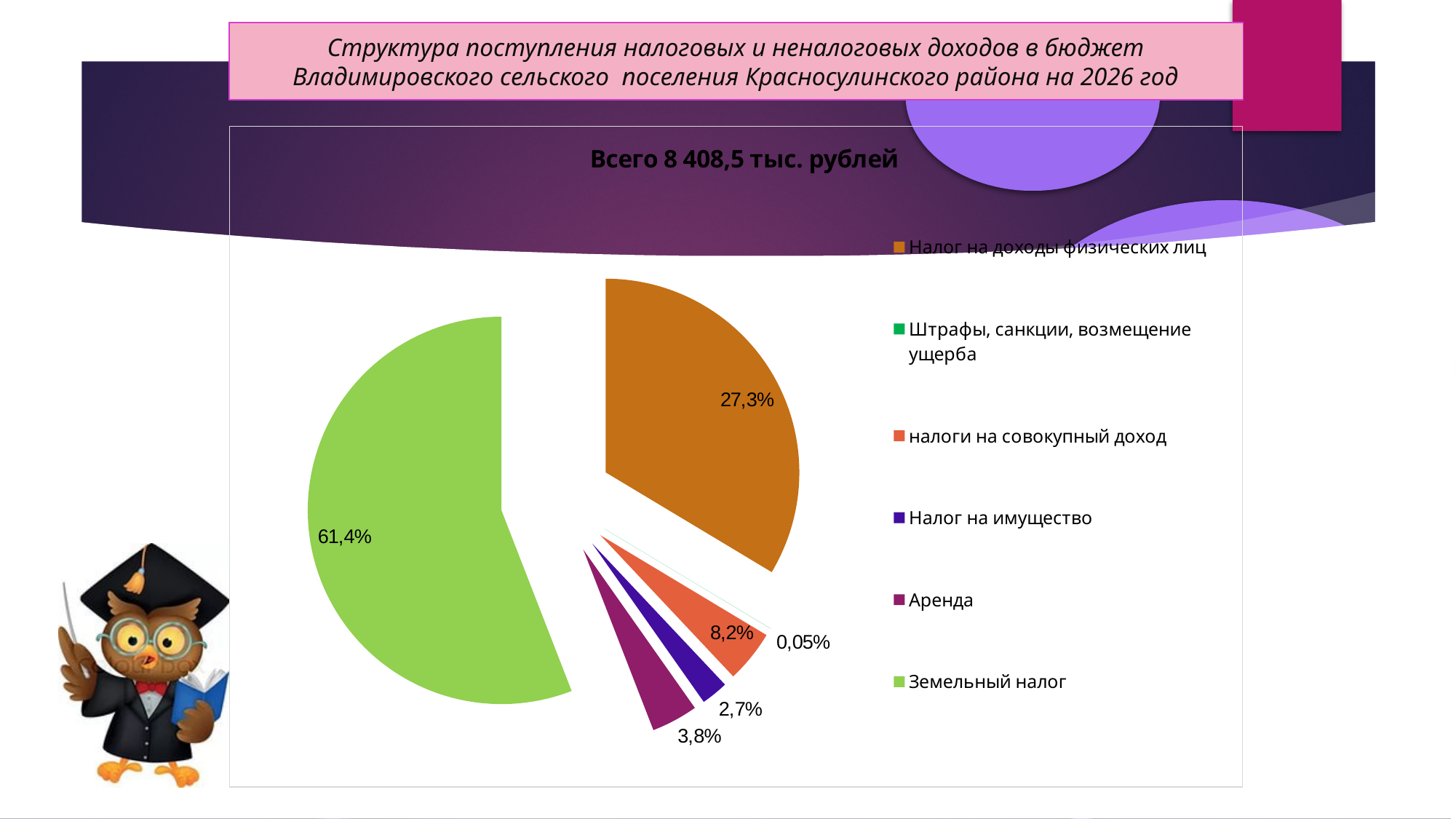
Which category has the smallest share of the pie? Штрафы, санкции, возмещение ущерба Which has the larger share, Аренда or Налог на имущество? Аренда What is the difference in percentage points between the shares of Земельный налог and Налог на доходы физических лиц? 34,1 What share of the pie does Аренда account for? 3,8% What share of the pie does налоги на совокупный доход account for? 8,2% How many categories does the legend list? 6 What share of the pie does Налог на имущество account for? 2,7% What total amount is stated in the chart title? 8 408,5 тыс. рублей Which category has the largest share of the pie? Земельный налог